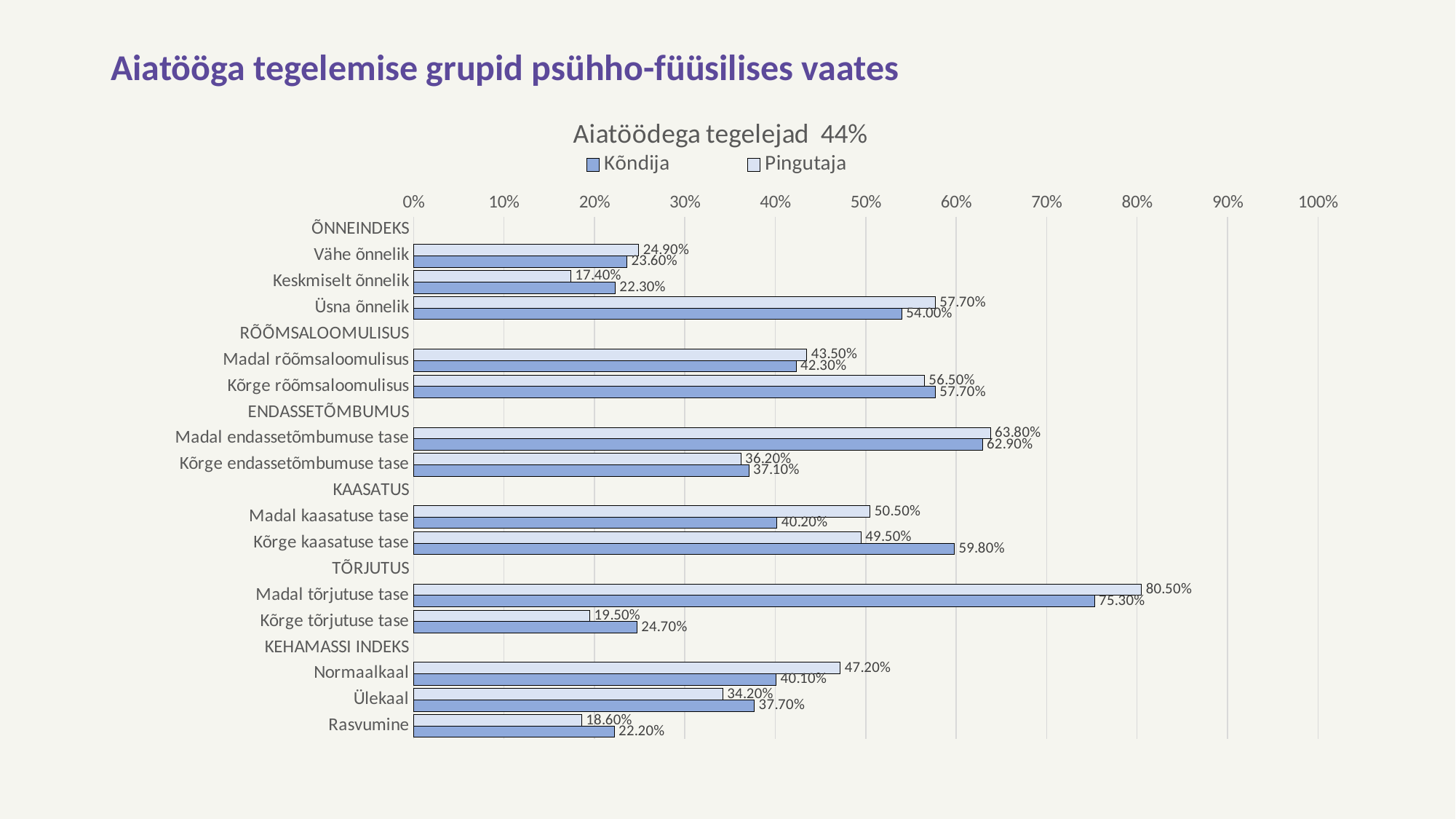
What is the Pingutaja value for Üsna õnnelik? 57.70% Which category has the highest Pingutaja value? Madal tõrjutuse tase What is the Kõndija value for Kõrge kaasatuse tase? 59.80% What is the title of the chart? Aiatöödega tegelejad 44% How many series does the legend list? 2 What kind of chart is shown on the slide? Bar chart Which category has the lowest Pingutaja value? Keskmiselt õnnelik What is the Kõndija value for Madal tõrjutuse tase? 75.30% Which is larger for Normaalkaal, the Kõndija value or the Pingutaja value? Pingutaja Is the Kõndija value for Madal endassetõmbumuse tase greater or less than 60%? greater What is the Pingutaja value for Rasvumine? 18.60% What is the difference between the Pingutaja and Kõndija values for Madal kaasatuse tase? 10.30%